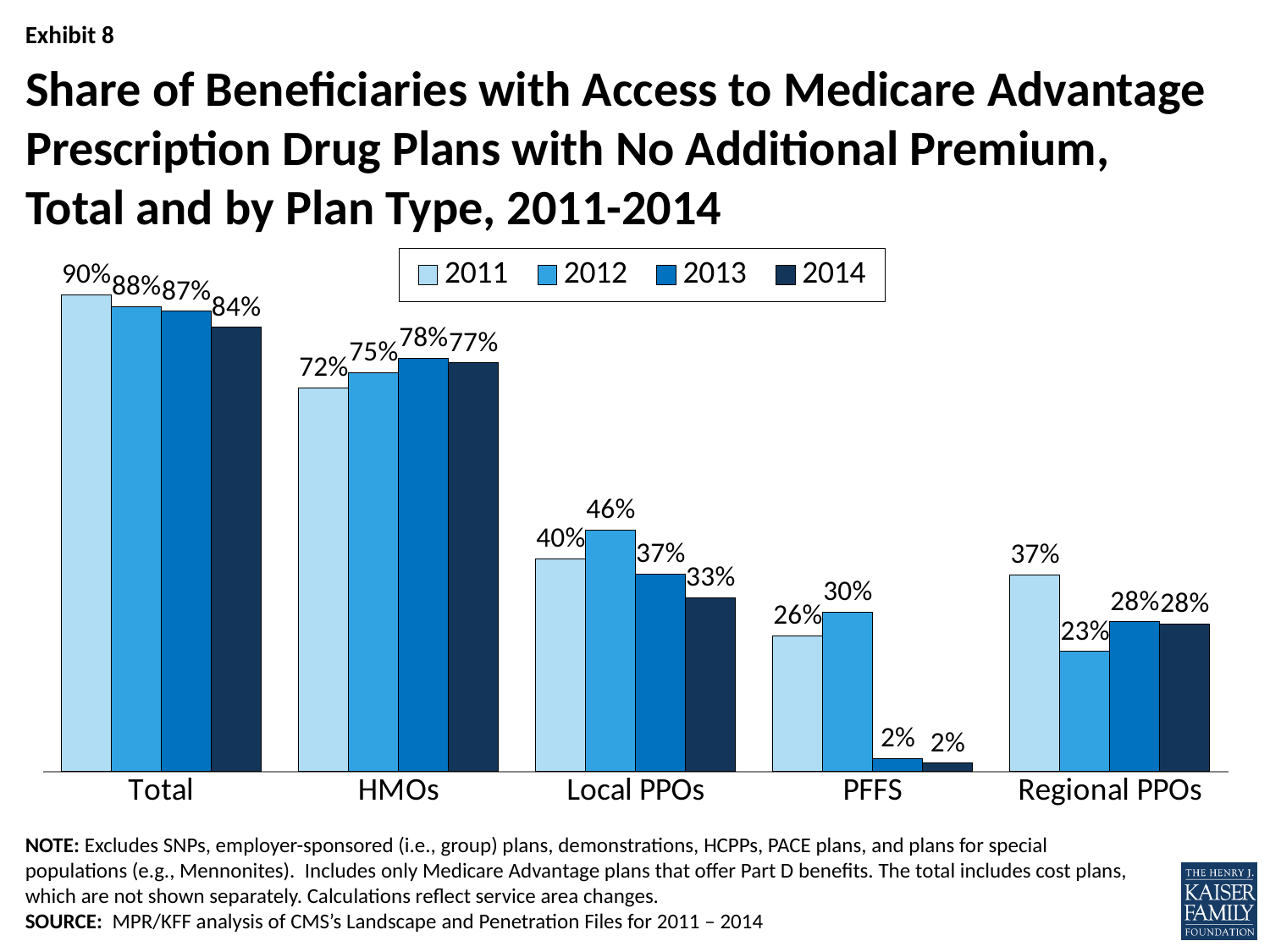
What is the value for Local PPOs in 2012? 46% Which category has the highest value in 2011? Total How many categories are shown on the x axis? 5 What is the value for PFFS in 2014? 2% Which is larger, the 2012 value for Local PPOs or the 2012 value for PFFS? Local PPOs What is the value for Regional PPOs in 2012? 23% What is the value for Total in 2011? 90% What is the difference between the Total values for 2011 and 2014? 6% Which plan type has the lowest value in 2014? PFFS What kind of chart is shown on the slide? Bar chart How many series does the legend list? 4 What is the value for HMOs in 2013? 78%